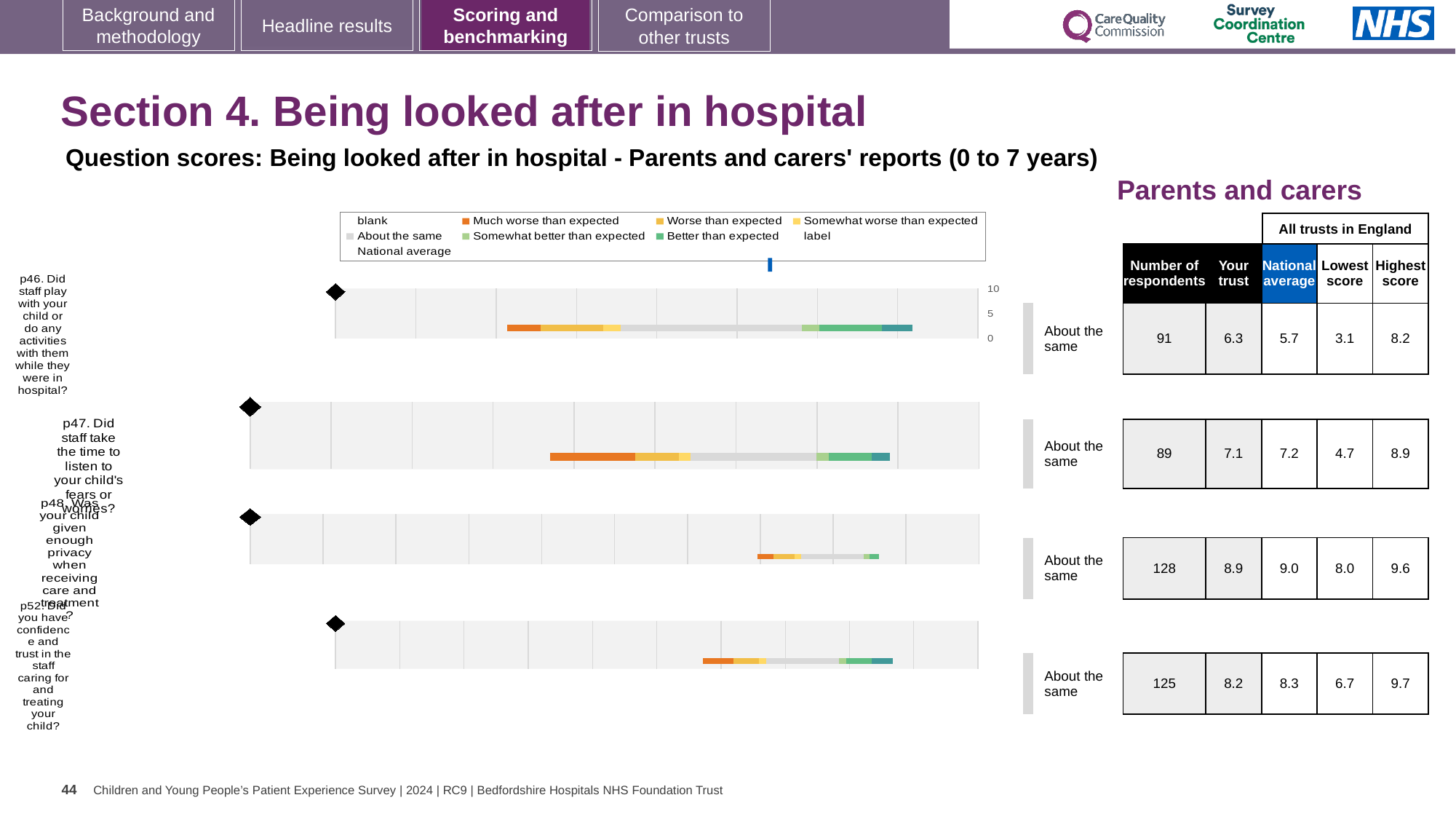
What kind of chart is used to show the question scores on this slide? bar chart How many question charts are shown on the slide? 4 Which question has the highest 'Your trust' score? p48 Which question has the lowest number of respondents? p47 For p46, which is larger: the 'Your trust' score or the national average? Your trust What is the 'Your trust' score for p46 (Did staff play with your child or do any activities with them while they were in hospital?)? 6.3 What is the national average score for p47 (Did staff take the time to listen to your child's fears or worries?)? 7.2 What is the highest value shown on the chart axis? 10 For p48, what is the difference between the highest score and the lowest score across all trusts in England? 1.6 What benchmark category is shown beside each of the four charts? About the same What is the number of respondents for p52 (Did you have confidence and trust in the staff caring for and treating your child?)? 125 Which colour in the legend represents 'Much worse than expected'? orange